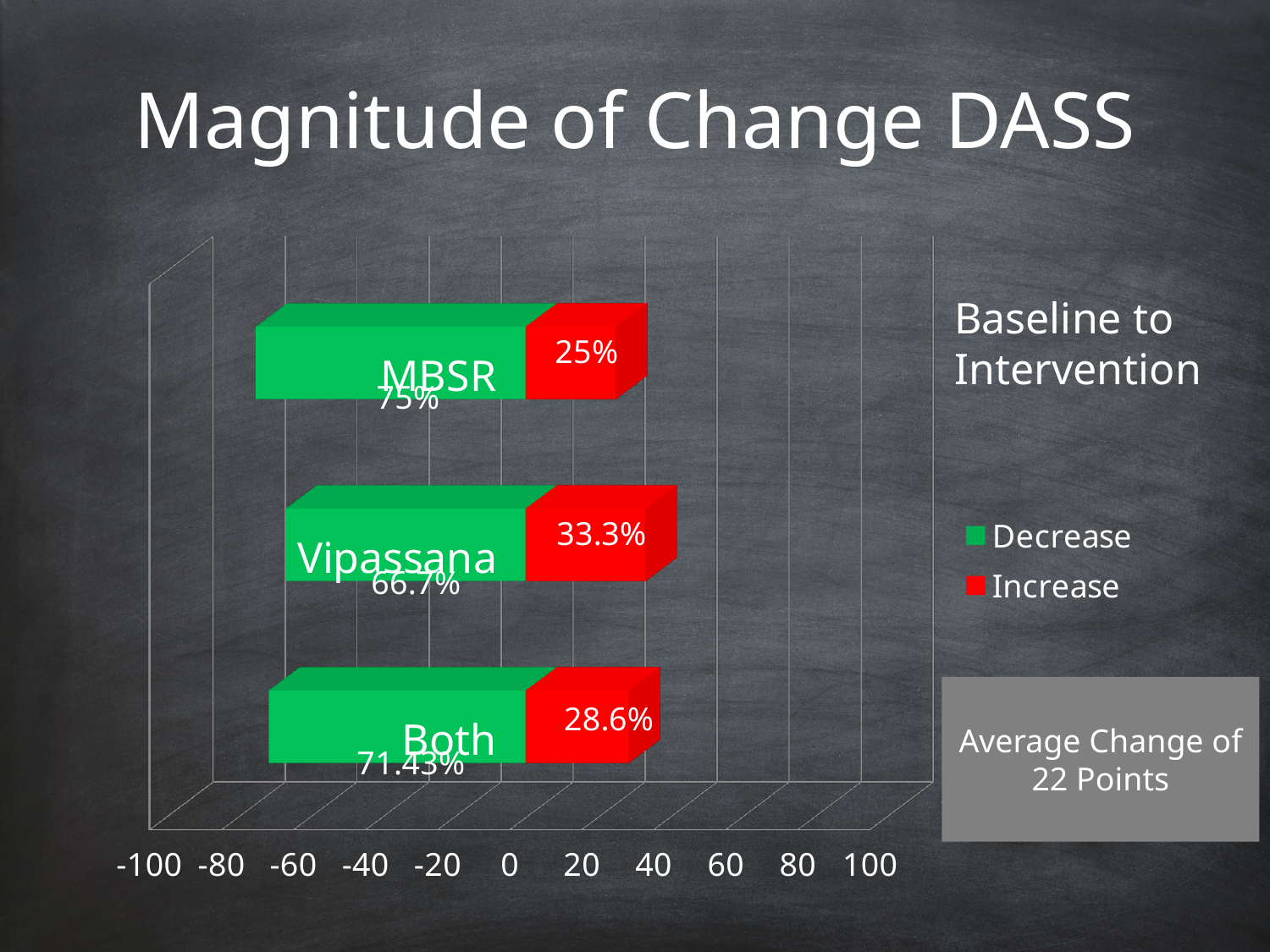
What is the Increase value for Both? 28.6% What kind of chart is shown on the slide? Bar chart What is the difference between the Increase values for Vipassana and MBSR? 8.3% What is the Decrease value for Both? 71.43% Which category has the highest Increase value? Vipassana Which category has the lowest Increase value? MBSR Which category has the highest Decrease value? MBSR How many series does the legend list? 2 Which is larger, the Increase value for Both or the Increase value for MBSR? Both What is the Increase value for Vipassana? 33.3% What is the Decrease value for MBSR? 75% How many categories are shown on the chart? 3